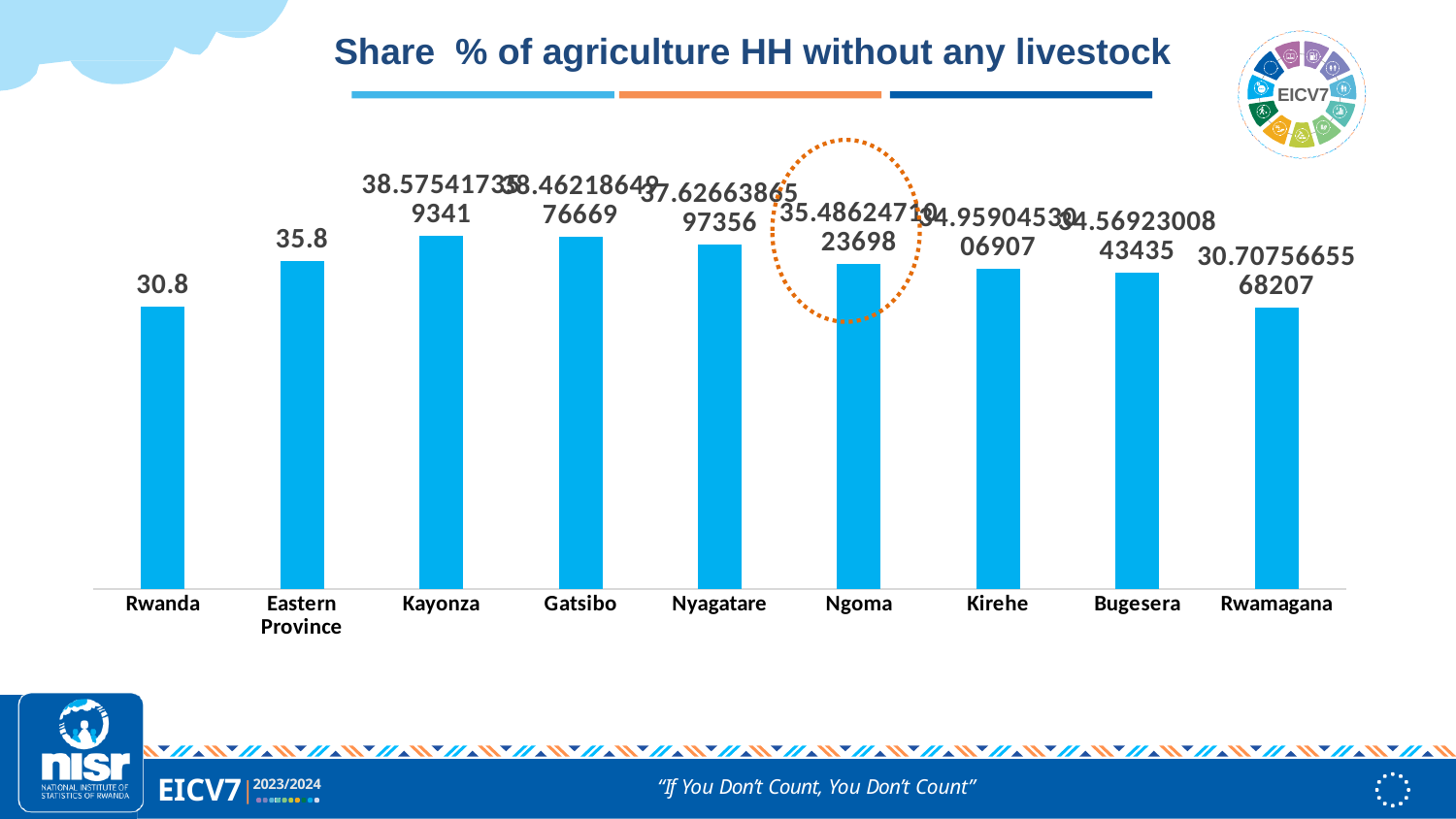
How many categories are shown on the x axis? 9 What is the value for Rwanda? 30.8 What is the title of the chart? Share % of agriculture HH without any livestock What kind of chart is shown on the slide? Bar chart Which is larger, the value for Nyagatare or the value for Bugesera? Nyagatare What is the difference between the values for Eastern Province and Rwanda? 5 Which is larger, the value for Eastern Province or the value for Rwanda? Eastern Province Which is larger, the value for Kayonza or the value for Rwamagana? Kayonza Which category's bar is highlighted with a dotted orange circle? Ngoma Do the values rise or fall from Kayonza to Rwamagana along the x axis? Fall What is the value for Eastern Province? 35.8